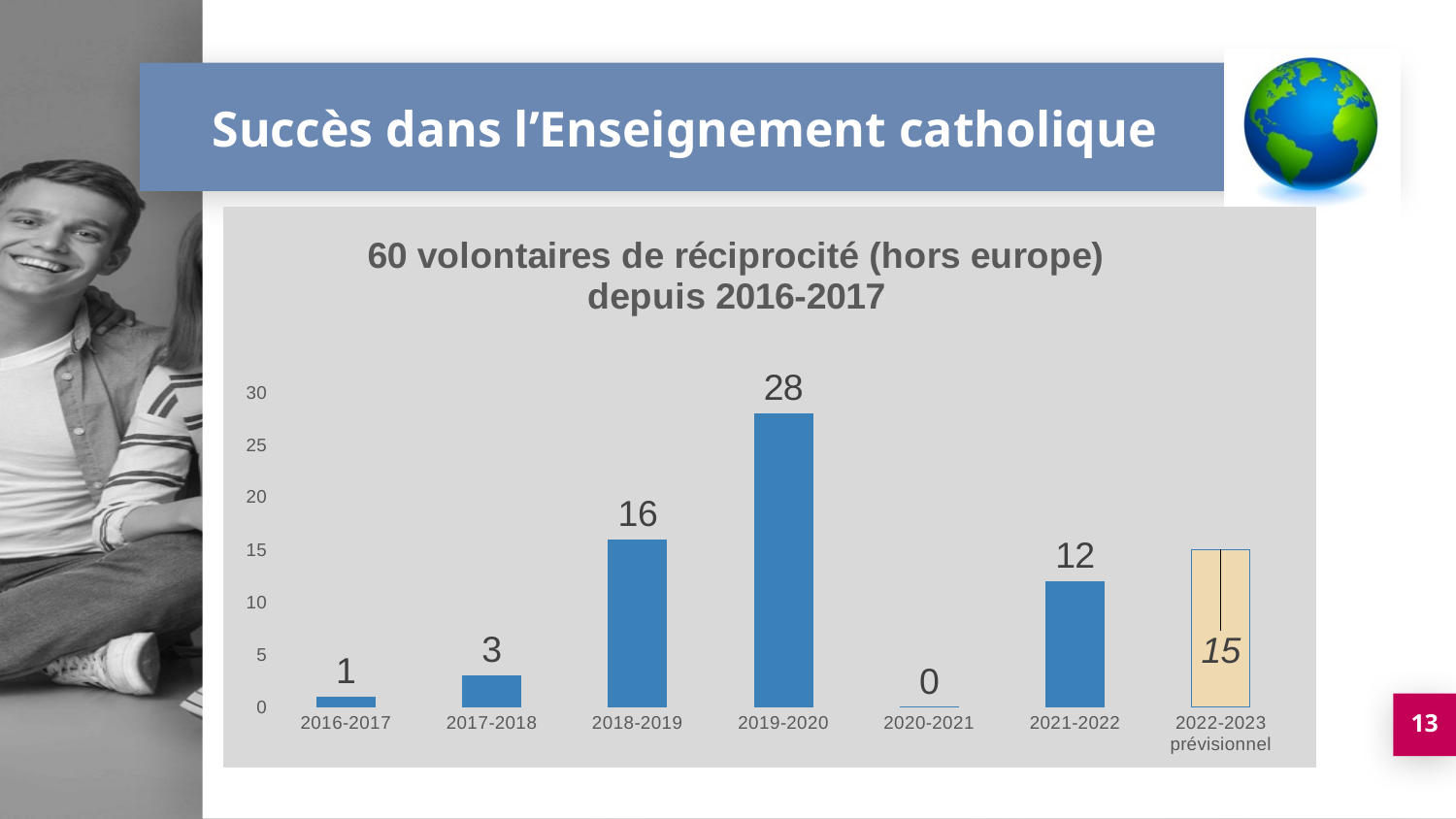
Which is larger, the value for 2017-2018 or the value for 2021-2022? 2021-2022 What is the title of the chart? 60 volontaires de réciprocité (hors europe) depuis 2016-2017 Do the values rise or fall from 2016-2017 to 2019-2020? rise What is the value for 2018-2019? 16 What is the difference between the values for 2019-2020 and 2021-2022? 16 What is the value for 2022-2023 prévisionnel? 15 What is the value for 2020-2021? 0 What is the value for 2019-2020? 28 Which year has the lowest value? 2020-2021 How many categories are shown on the x axis? 7 What kind of chart is this? bar chart Which year has the highest value? 2019-2020